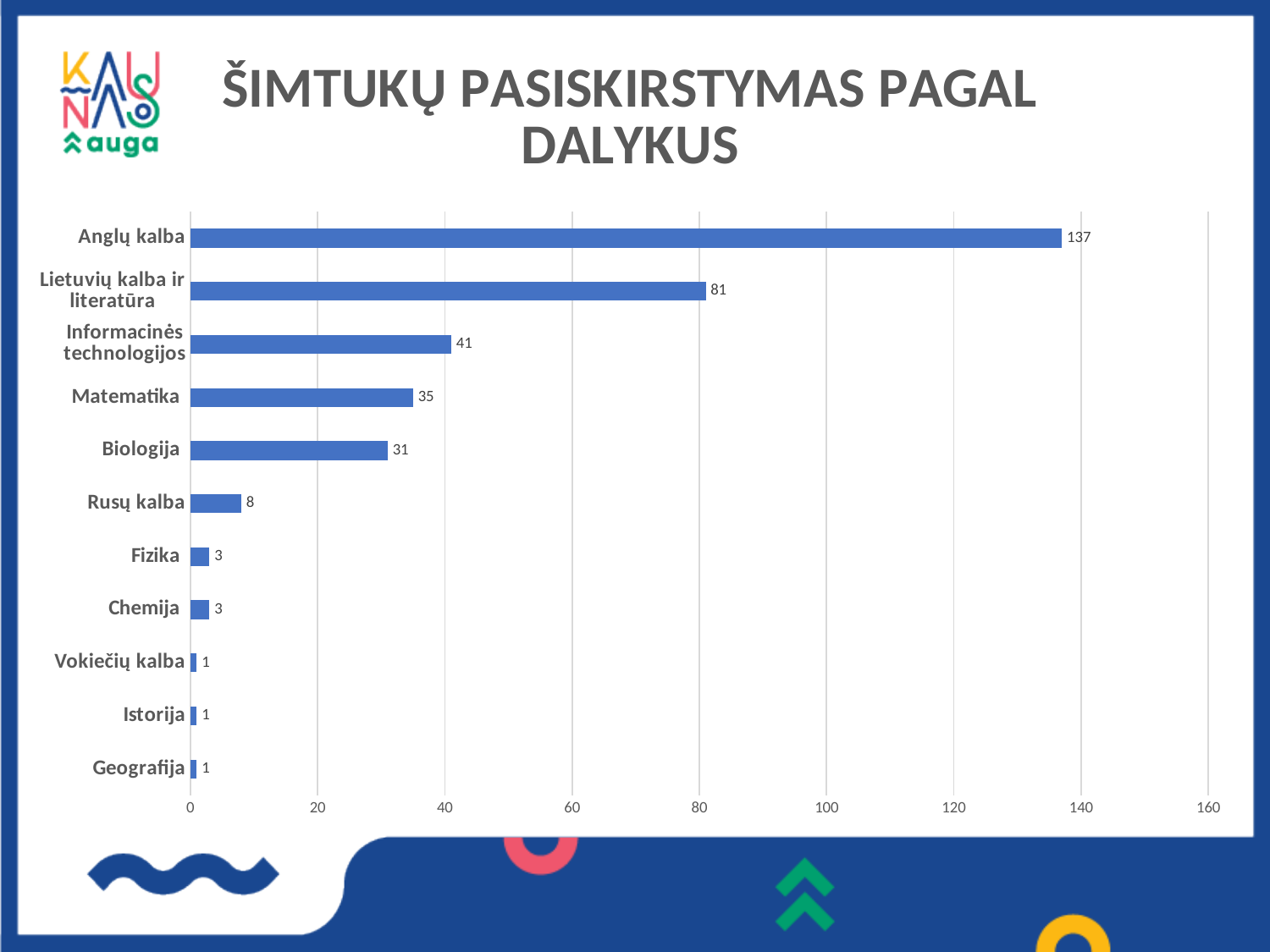
What is the value for Anglų kalba? 137 How many categories are shown in the chart? 11 What is the difference between the values for Anglų kalba and Lietuvių kalba ir literatūra? 56 Is the value for Lietuvių kalba ir literatūra greater or less than 100? less What is the value for Rusų kalba? 8 What is the value for Lietuvių kalba ir literatūra? 81 What is the difference between the values for Informacinės technologijos and Matematika? 6 Which is larger, the value for Matematika or the value for Biologija? Matematika What is the title of the slide? ŠIMTUKŲ PASISKIRSTYMAS PAGAL DALYKUS Which category has the highest value? Anglų kalba What is the value for Biologija? 31 What kind of chart is shown on the slide? bar chart